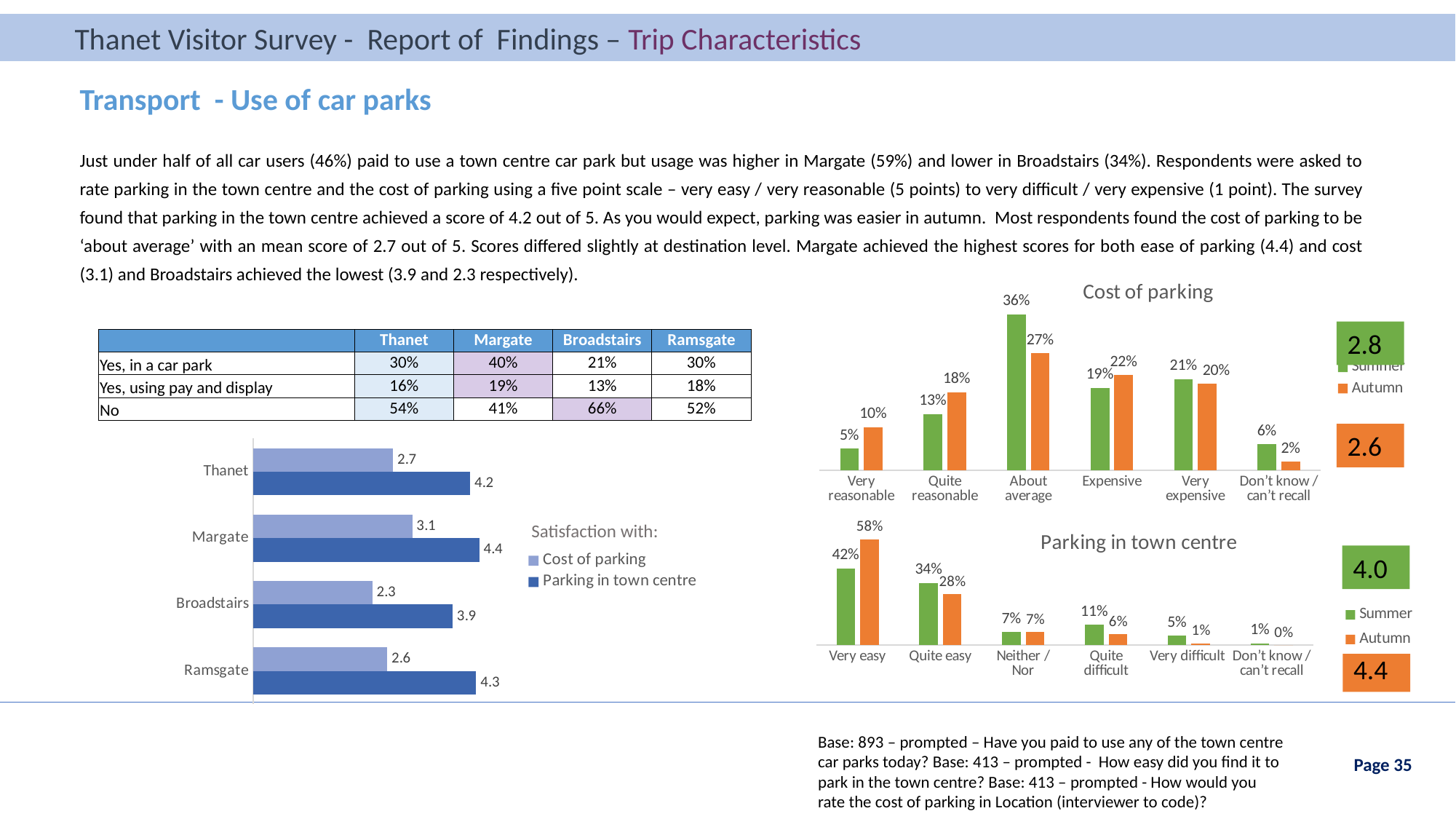
In the 'Cost of parking' chart, what is the difference between the Summer and Autumn values for Very reasonable? 5% In the 'Satisfaction with' bar chart at the bottom left, how many series does the legend list? 2 In the 'Satisfaction with' bar chart at the bottom left, what is the difference between the Parking in town centre and Cost of parking scores for Thanet? 1.5 In the 'Satisfaction with' bar chart at the bottom left, which destination has the lowest Cost of parking score? Broadstairs How many categories are shown on the x axis of the 'Parking in town centre' chart? 6 In the 'Cost of parking' chart, what is the Summer value for About average? 36% In the 'Parking in town centre' chart, which is larger for Quite easy: Summer or Autumn? Summer In the 'Cost of parking' chart, which category has the highest Autumn value? About average In the 'Satisfaction with' bar chart at the bottom left, what is the value for Cost of parking for Broadstairs? 2.3 What kind of chart is the 'Satisfaction with' chart at the bottom left? Bar chart In the 'Parking in town centre' chart, what is the Autumn value for Very easy? 58% In the 'Satisfaction with' bar chart at the bottom left, what is the value for Parking in town centre for Margate? 4.4